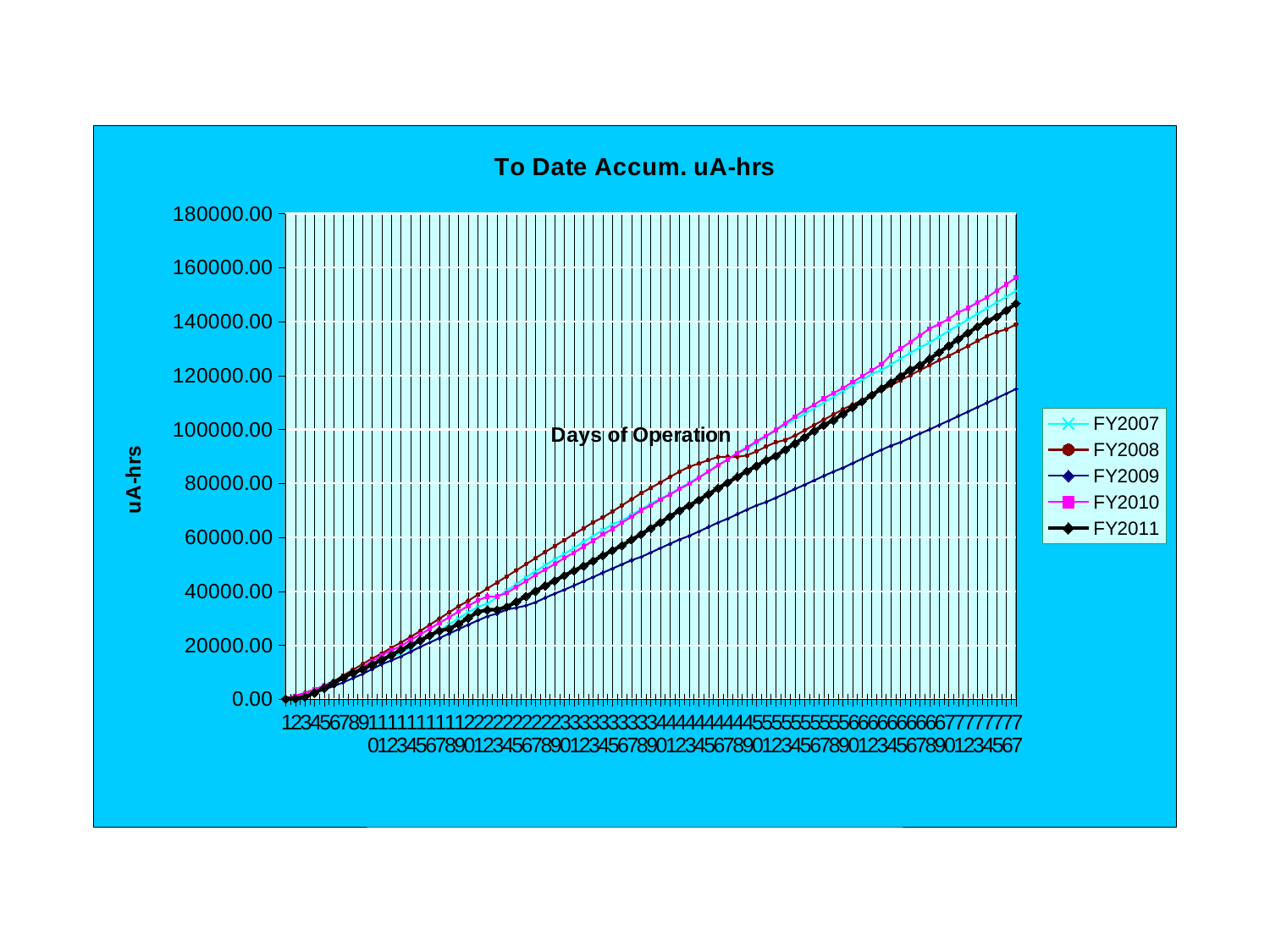
Is the final value for FY2010 greater or less than 140000.00? greater What is the title of the chart? To Date Accum. uA-hrs Which series has the highest value at the final day of operation shown? FY2010 What is the label on the vertical axis? uA-hrs How many series does the legend list? 5 Is the final value for FY2009 greater or less than 120000.00? less Do the values for each series rise or fall as the days of operation increase? rise Which series has the lowest value at the final day of operation shown? FY2009 Is the final value for FY2009 greater or less than 100000.00? greater What kind of chart is shown on the slide? line chart At the final day of operation shown, which is larger, the value for FY2010 or the value for FY2009? FY2010 At the final day of operation shown, which is larger, the value for FY2008 or the value for FY2009? FY2008